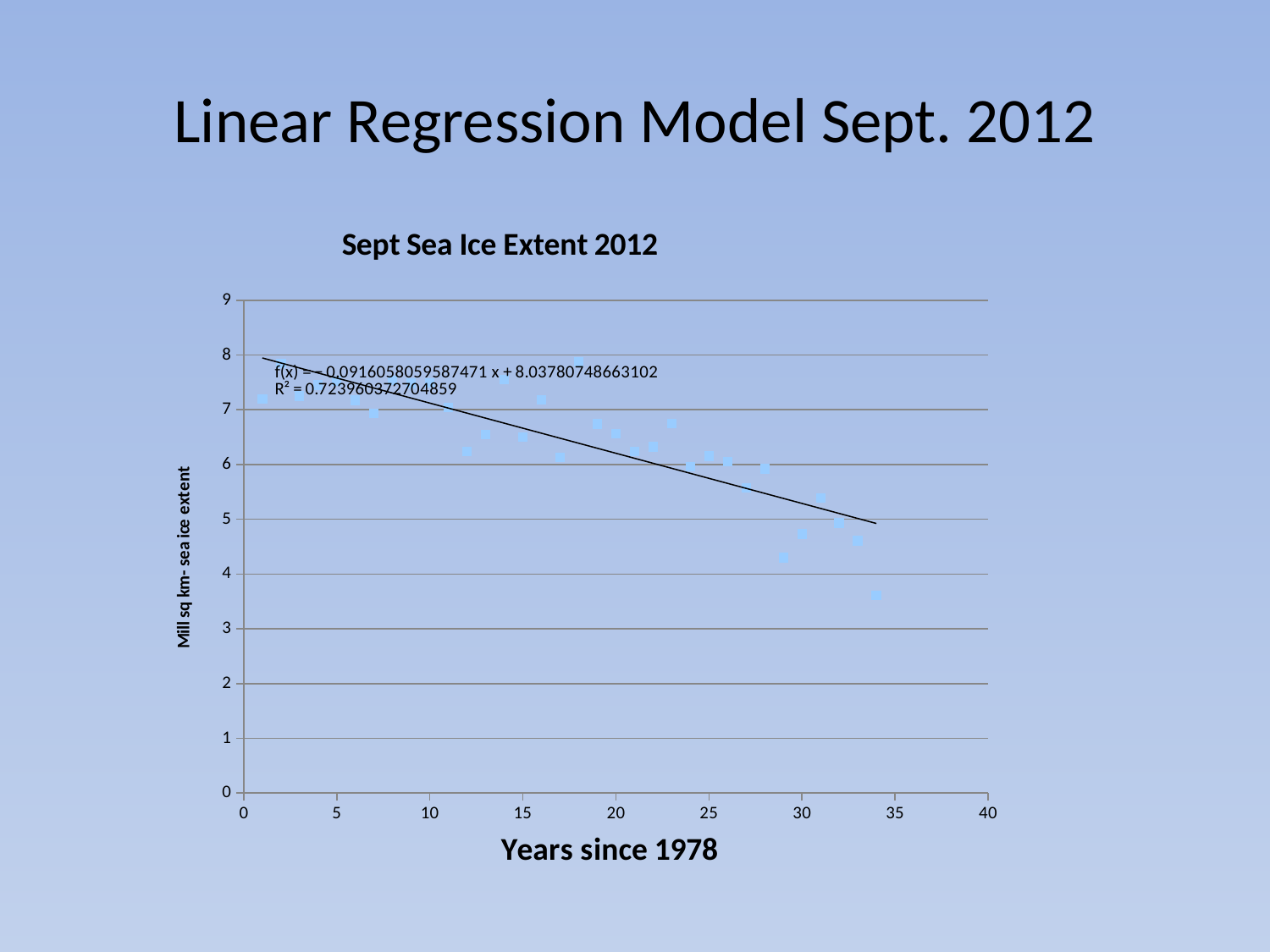
Which is larger, the sea ice extent at 3 years since 1978 or at 33 years since 1978? 3 years since 1978 What is the label of the x axis? Years since 1978 Is the sea ice extent value at 34 years since 1978 greater or less than 4? less Is the sea ice extent value at 18 years since 1978 greater or less than 7? greater What is the title of the chart? Sept Sea Ice Extent 2012 What R² value is shown for the trendline on the chart? 0.723960372704859 At how many years since 1978 is the lowest sea ice extent plotted? 34 What kind of chart is shown on the slide? scatter chart Do the plotted sea ice extent values generally rise or fall as years since 1978 increase? fall Is the sea ice extent value at 1 year since 1978 greater or less than 7? greater